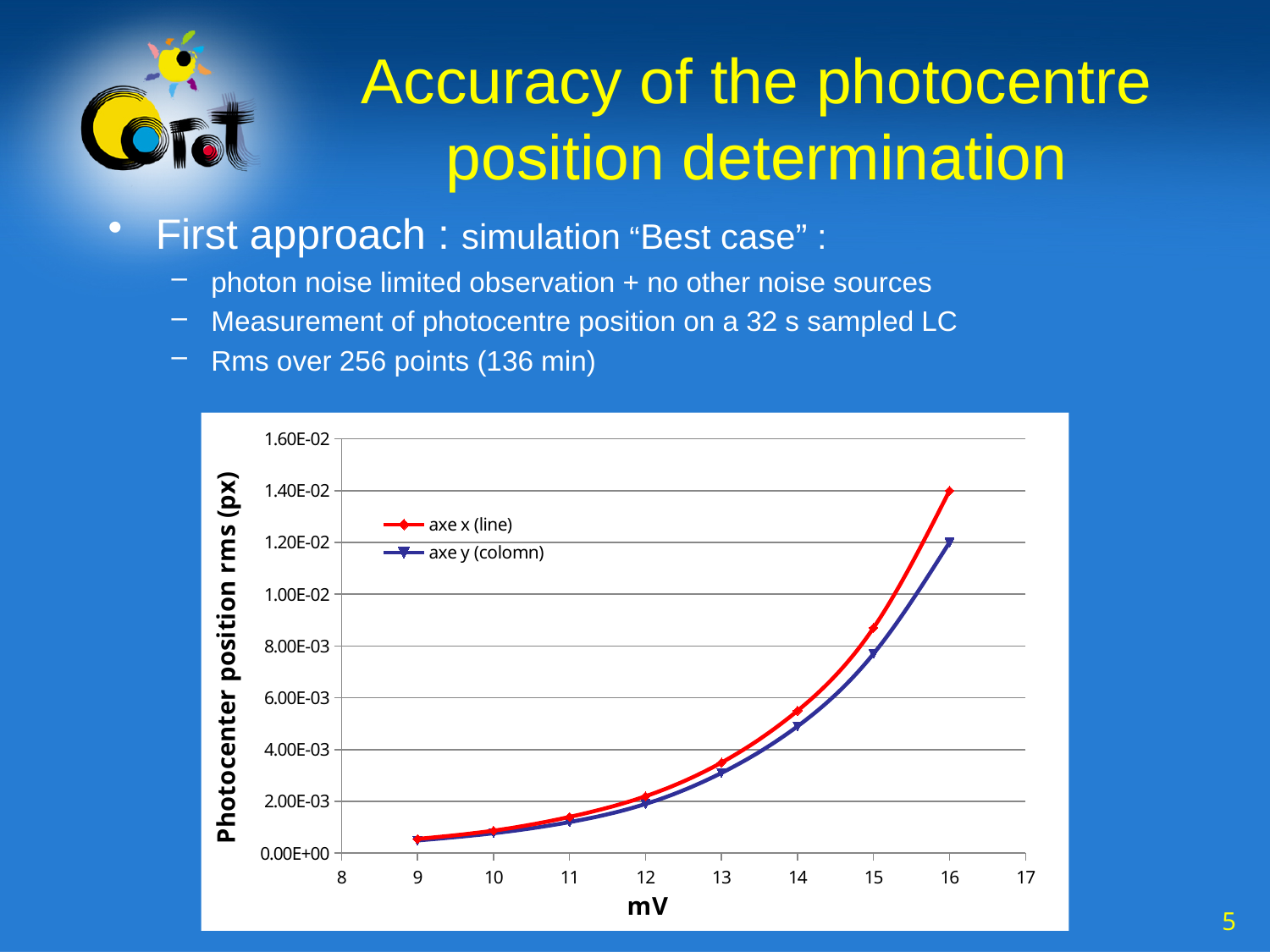
What is the value of the axe x (line) series at 16 mV? 1.40E-02 At which mV value does the axe y (colomn) series reach its highest value? 16 Is the value for axe x (line) at 15 mV greater or less than 8.00E-03? greater What is the label of the x axis? mV Do the values of the axe x (line) series rise or fall as mV increases? rise How many data points are plotted for the axe x (line) series? 8 How many series does the legend list? 2 At which mV value is the axe x (line) series lowest? 9 Is the value for axe y (colomn) at 14 mV greater or less than 6.00E-03? less What kind of chart is shown on the slide? line chart At 15 mV, which series has the higher photocenter position rms: axe x (line) or axe y (colomn)? axe x (line) What are the two series named in the legend? axe x (line) and axe y (colomn)